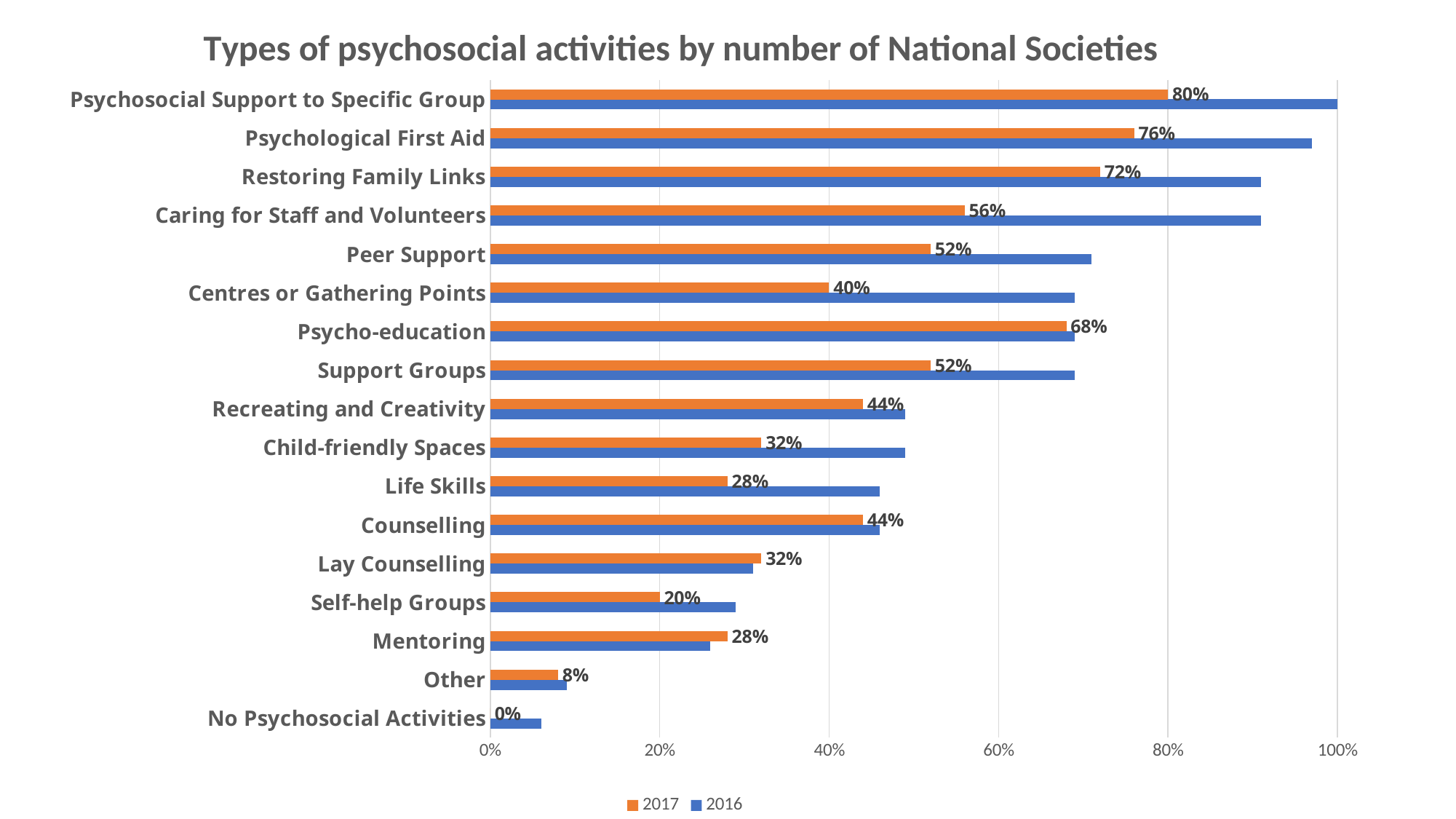
What is the 2017 value for Psychological First Aid? 76% What kind of chart is shown on the slide? bar chart Is the 2016 value for Caring for Staff and Volunteers greater or less than 80%? greater How many series does the legend list? 2 Which category has the highest 2017 value? Psychosocial Support to Specific Group Is the 2016 value for No Psychosocial Activities greater or less than 20%? less Which category has the lowest 2017 value? No Psychosocial Activities How many activity categories are shown on the chart? 17 Which colour represents the 2017 series in the legend? orange Which has the larger 2017 value, Centres or Gathering Points or Psycho-education? Psycho-education What is the 2017 value for Psycho-education? 68% What is the difference between the 2017 values for Restoring Family Links and Caring for Staff and Volunteers? 16 percentage points